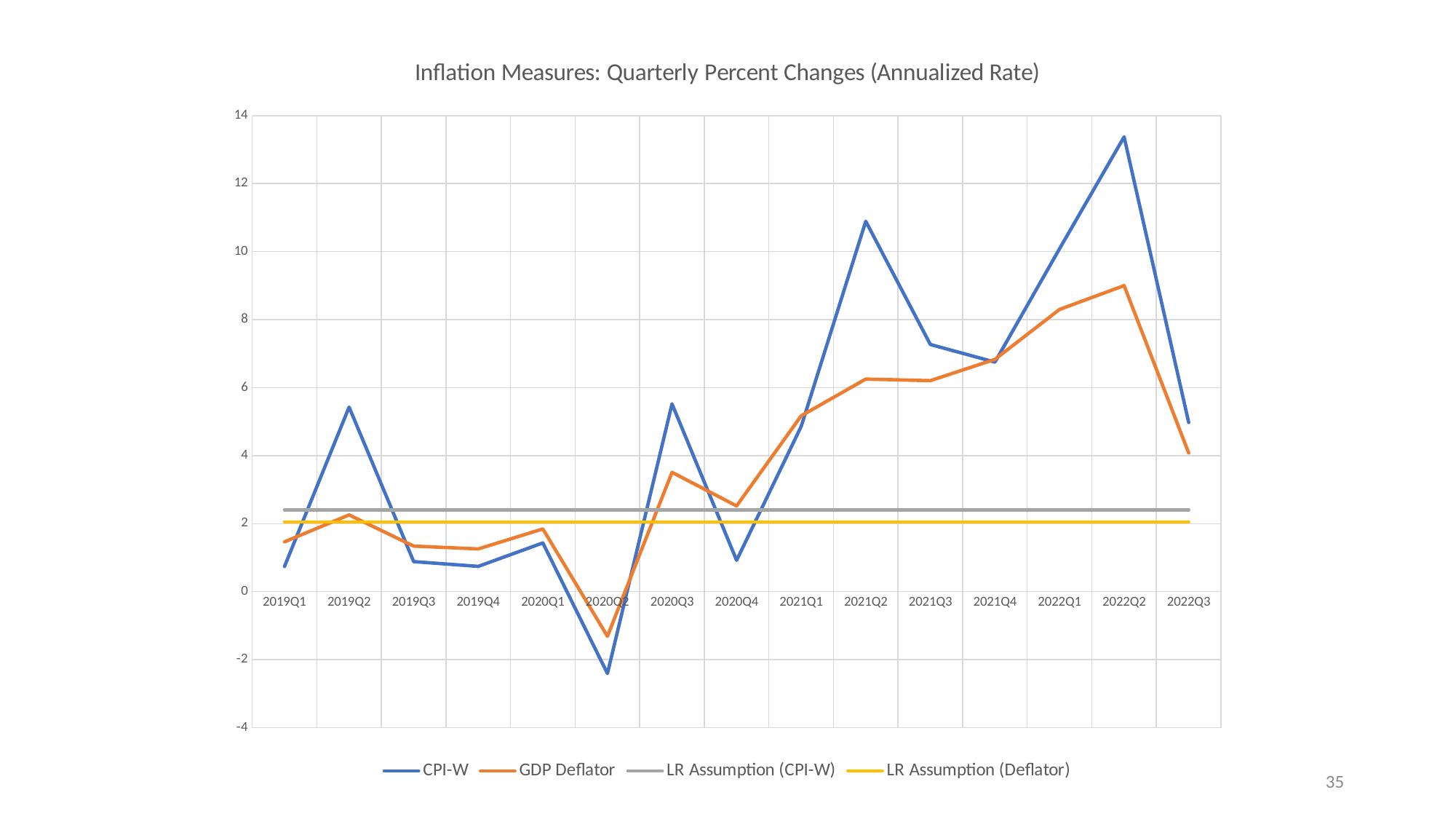
What kind of chart is shown on the slide? Line chart Is the CPI-W value for 2021Q2 greater or less than 10? greater How many series does the legend list? 4 In 2020Q4, which is larger: CPI-W or GDP Deflator? GDP Deflator What is the title of the chart? Inflation Measures: Quarterly Percent Changes (Annualized Rate) Does the CPI-W series rise or fall from 2020Q4 to 2021Q2? Rise How many quarters are plotted along the x axis? 15 Is the CPI-W value for 2022Q2 greater or less than 12? greater In which quarter does the CPI-W series reach its lowest value? 2020Q2 In which quarter does the CPI-W series reach its highest value? 2022Q2 In which quarter does the GDP Deflator series reach its highest value? 2022Q2 Is the GDP Deflator value for 2020Q2 greater or less than 0? less